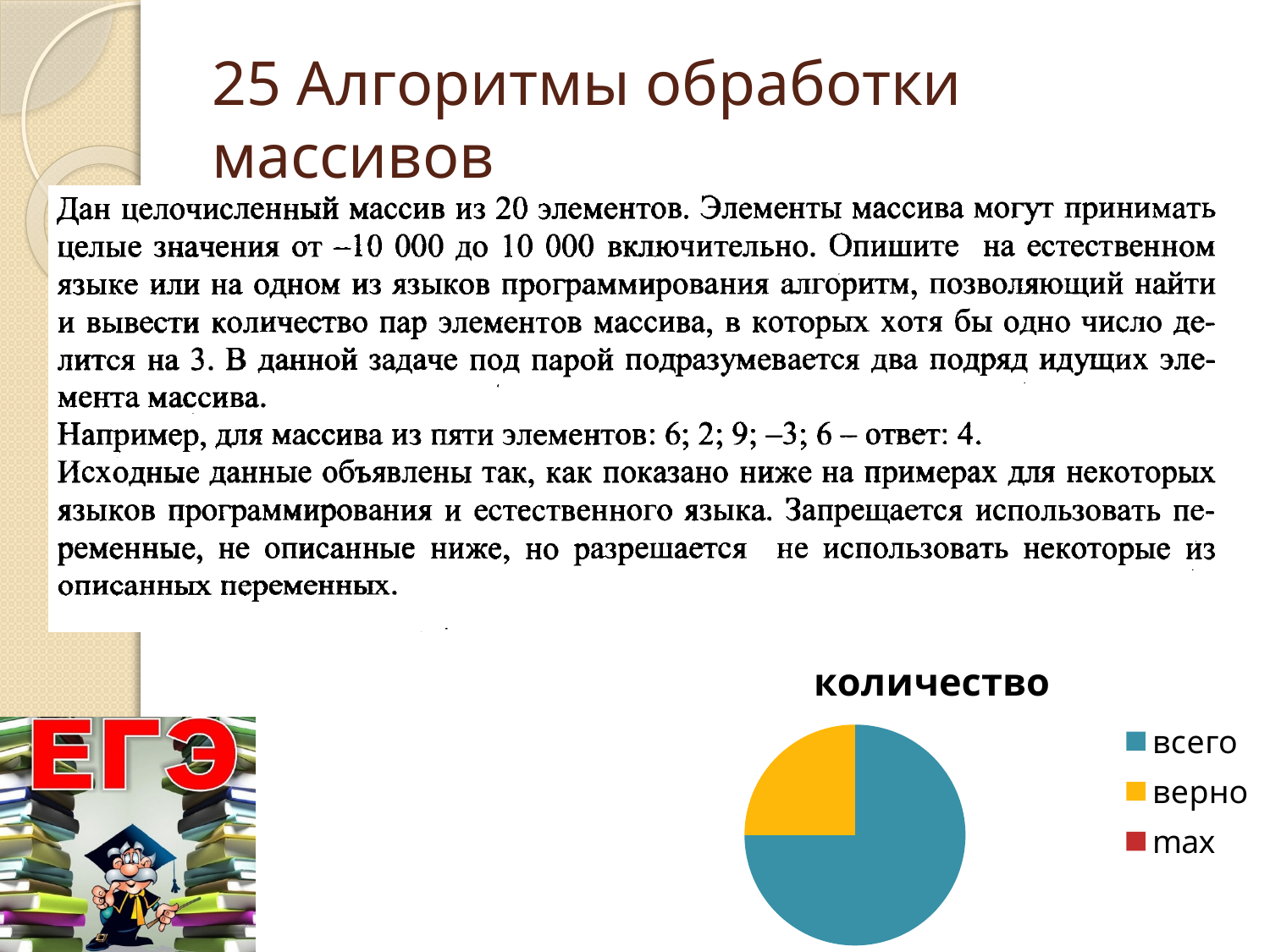
Which category has the largest slice in the pie chart? всего Which colour represents the category верно in the pie chart? yellow How many slices are visibly drawn in the pie chart? 2 What kind of chart is shown on the slide? pie chart Is the share of the всего slice in the pie chart greater or less than 50%? greater Is the share of the верно slice in the pie chart greater or less than 50%? less What is the title of the pie chart? количество Which slice is larger in the pie chart, всего or верно? всего How many entries does the legend of the pie chart list? 3